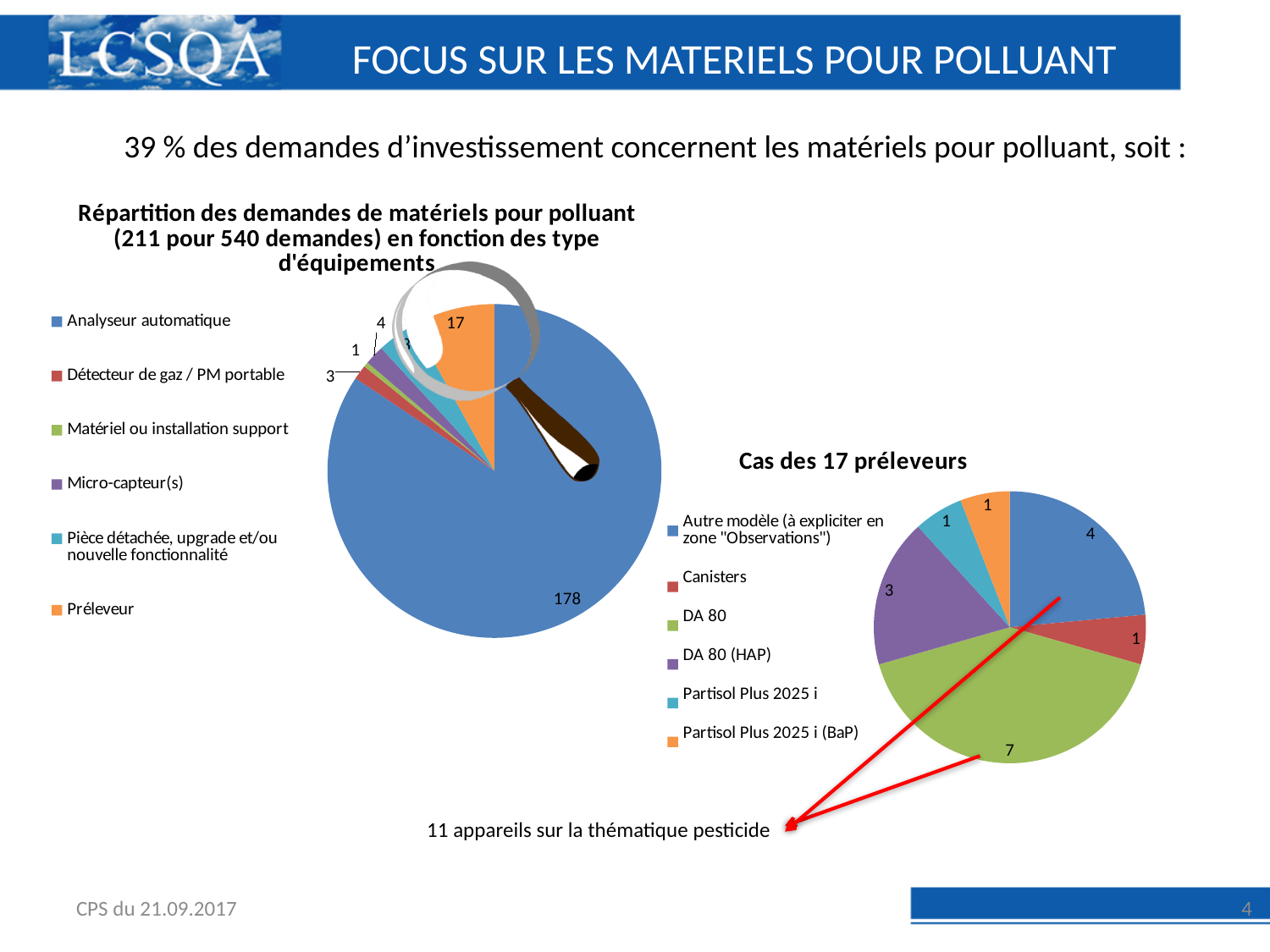
In the chart titled "Cas des 17 préleveurs", what is the value for DA 80 (HAP)? 3 In the chart titled "Répartition des demandes de matériels pour polluant", which category has the largest slice? Analyseur automatique In the chart titled "Cas des 17 préleveurs", what is the value for DA 80? 7 What kind of chart is the chart titled "Répartition des demandes de matériels pour polluant"? pie chart In the chart titled "Répartition des demandes de matériels pour polluant", what is the value for Analyseur automatique? 178 How many categories are shown in the chart titled "Cas des 17 préleveurs"? 6 In the chart titled "Cas des 17 préleveurs", what is the difference between the values for DA 80 and Autre modèle (à expliciter en zone "Observations")? 3 In the chart titled "Répartition des demandes de matériels pour polluant", what is the value for Préleveur? 17 How many entries does the legend of the chart titled "Répartition des demandes de matériels pour polluant" list? 6 In the chart titled "Cas des 17 préleveurs", which category has the largest slice? DA 80 In the chart titled "Répartition des demandes de matériels pour polluant", which is larger: Détecteur de gaz / PM portable or Micro-capteur(s)? Micro-capteur(s) In the chart titled "Répartition des demandes de matériels pour polluant", what is the difference between the values for Préleveur and Micro-capteur(s)? 13